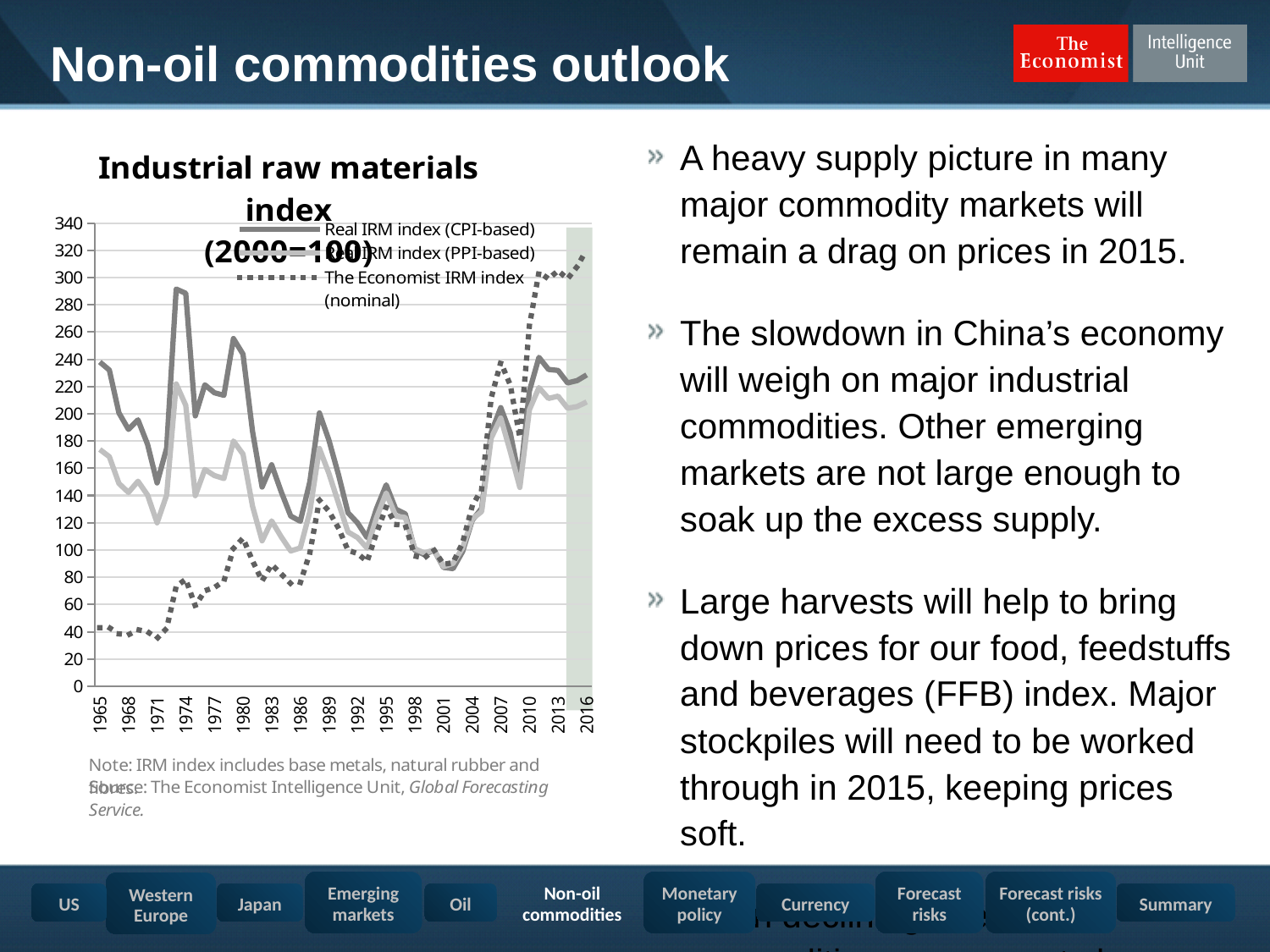
Is the value of The Economist IRM index (nominal) in 2016 greater or less than 300? greater Is the value of the Real IRM index (CPI-based) in 1974 greater or less than 280? greater What kind of chart is shown on the slide? Line chart Is the value of The Economist IRM index (nominal) in 1965 greater or less than 60? less Does The Economist IRM index (nominal) rise or fall overall between 2001 and 2016? Rise What is the highest value shown on the chart's vertical axis? 340 Which series has the highest value in 2016? The Economist IRM index (nominal) What is the last year labelled on the chart's horizontal axis? 2016 Which series is shown with a dotted line in the chart? The Economist IRM index (nominal) What is the title of the chart? Industrial raw materials index (2000=100) How many series does the chart's legend list? 3 In 1965, which is larger: the Real IRM index (CPI-based) or The Economist IRM index (nominal)? Real IRM index (CPI-based)